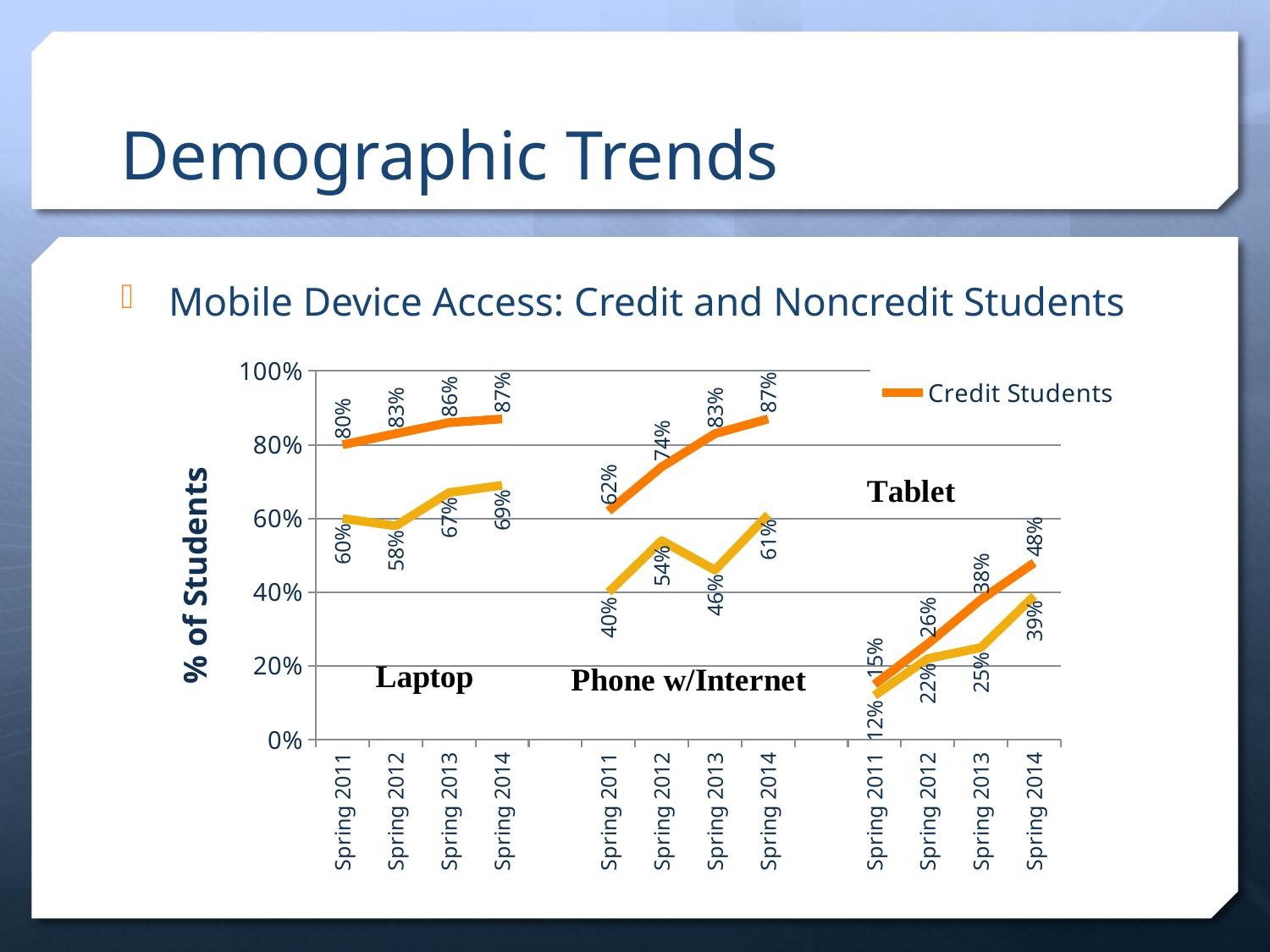
What is the Credit Students value for Tablet in Spring 2011? 15% How many device categories are shown on the chart? 3 What is the lowest value labelled anywhere on the chart? 12% What type of chart is shown on the slide? Line chart What is the value of the yellow line for Phone w/Internet in Spring 2012? 54% What is the difference between the Credit Students value and the yellow line value for Tablet in Spring 2014? 9 percentage points In which semester is the Credit Students value for Tablet the highest? Spring 2014 By how many percentage points did the Credit Students Laptop value increase from Spring 2011 to Spring 2014? 7 percentage points For Credit Students in Spring 2013, which is higher: Laptop or Phone w/Internet? Laptop What is the Credit Students value for Laptop in Spring 2014? 87% Do the Credit Students values for Tablet rise or fall from Spring 2011 to Spring 2014? Rise What is the title of the vertical axis? % of Students